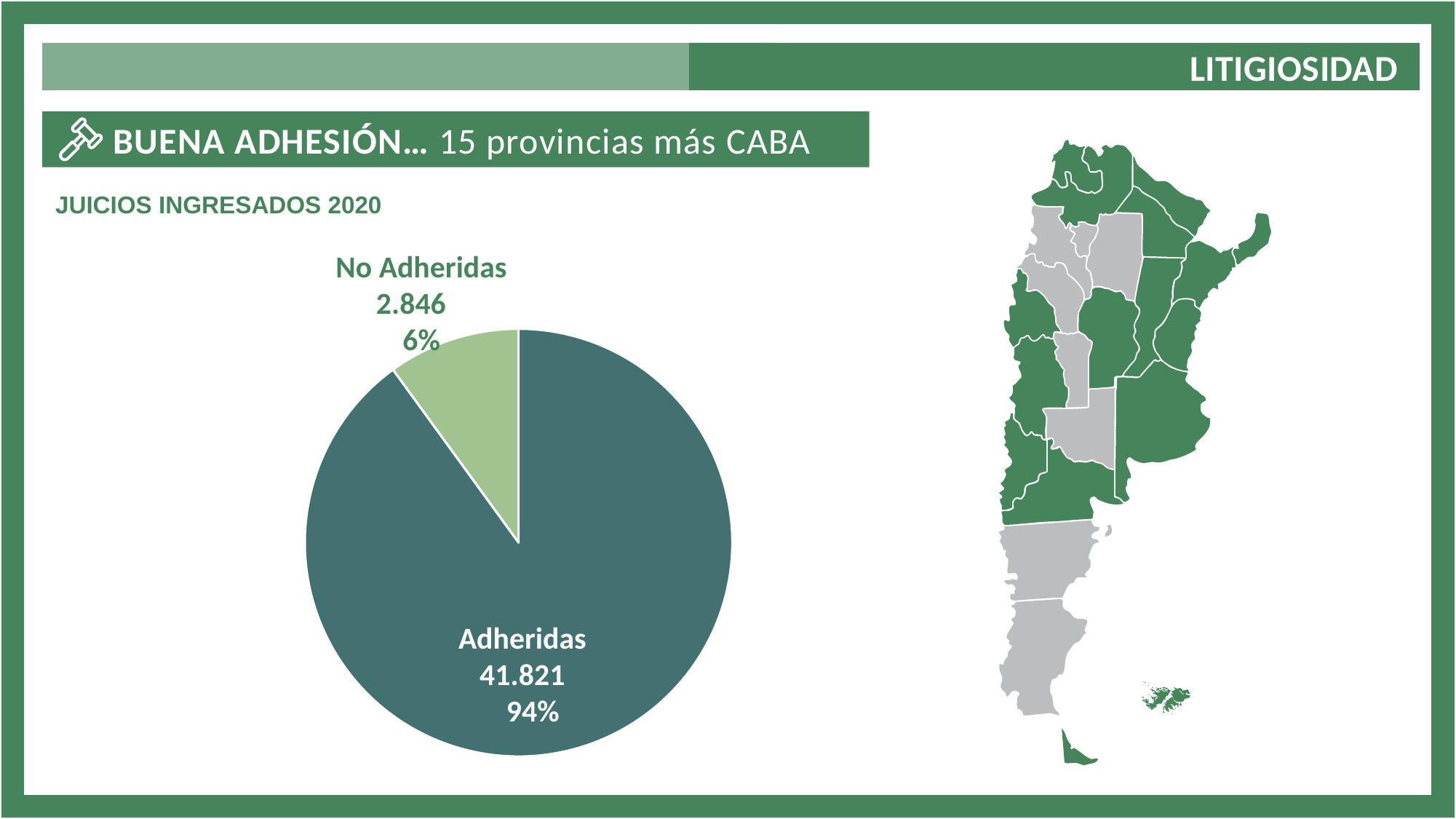
What is the value for Adheridas in the pie chart? 41.821 What is the difference between the Adheridas and No Adheridas values? 38.975 What share of the pie does the Adheridas slice represent? 94% How many slices does the pie chart have? 2 What is the total of the two slices in the pie chart? 44.667 Which is larger, Adheridas or No Adheridas? Adheridas What is the value for No Adheridas in the pie chart? 2.846 Which category has the largest slice in the pie chart? Adheridas What share of the pie does the No Adheridas slice represent? 6% What kind of chart is shown on the slide? pie chart What is the title of the pie chart? JUICIOS INGRESADOS 2020 Which category has the smallest slice in the pie chart? No Adheridas